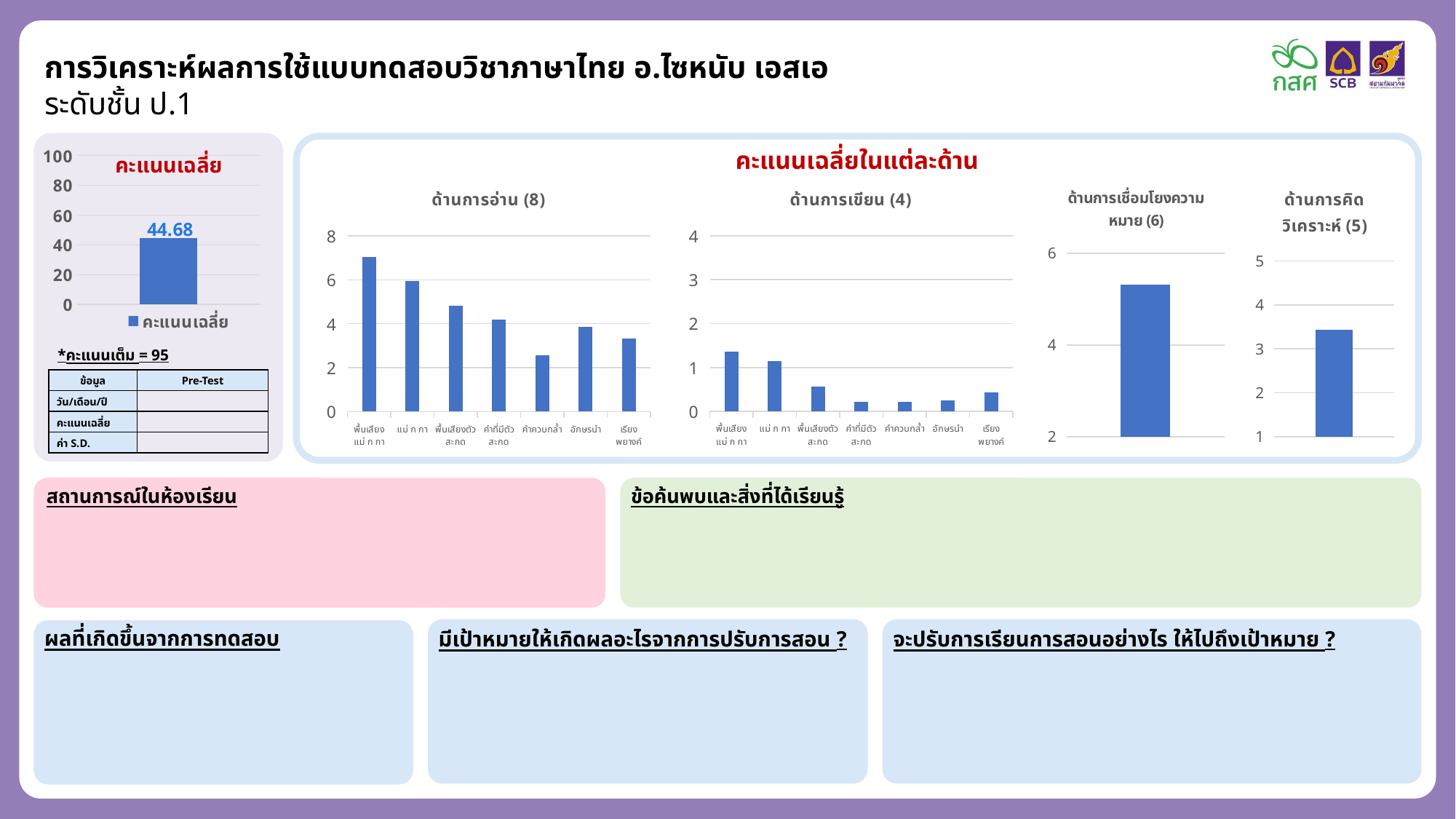
In the "ด้านการเขียน (4)" chart, which category has the highest value? พื้นเสียง แม่ ก กา In the "คะแนนเฉลี่ย" chart on the left, what value is shown for the bar? 44.68 In the "ด้านการอ่าน (8)" chart, which category has the highest value? พื้นเสียง แม่ ก กา In the "ด้านการอ่าน (8)" chart, which is larger: แม่ ก กา or อักษรนำ? แม่ ก กา What kind of chart is the "คะแนนเฉลี่ย" chart on the left? bar chart In the "ด้านการคิดวิเคราะห์ (5)" chart, is the value of the bar greater or less than 4? less In the "ด้านการอ่าน (8)" chart, is the value for คำควบกล้ำ greater or less than 4? less In the "ด้านการอ่าน (8)" chart, is the value for พื้นเสียง แม่ ก กา greater or less than 6? greater In the "ด้านการอ่าน (8)" chart, how many categories are plotted? 7 In the "ด้านการอ่าน (8)" chart, which category has the lowest value? คำควบกล้ำ